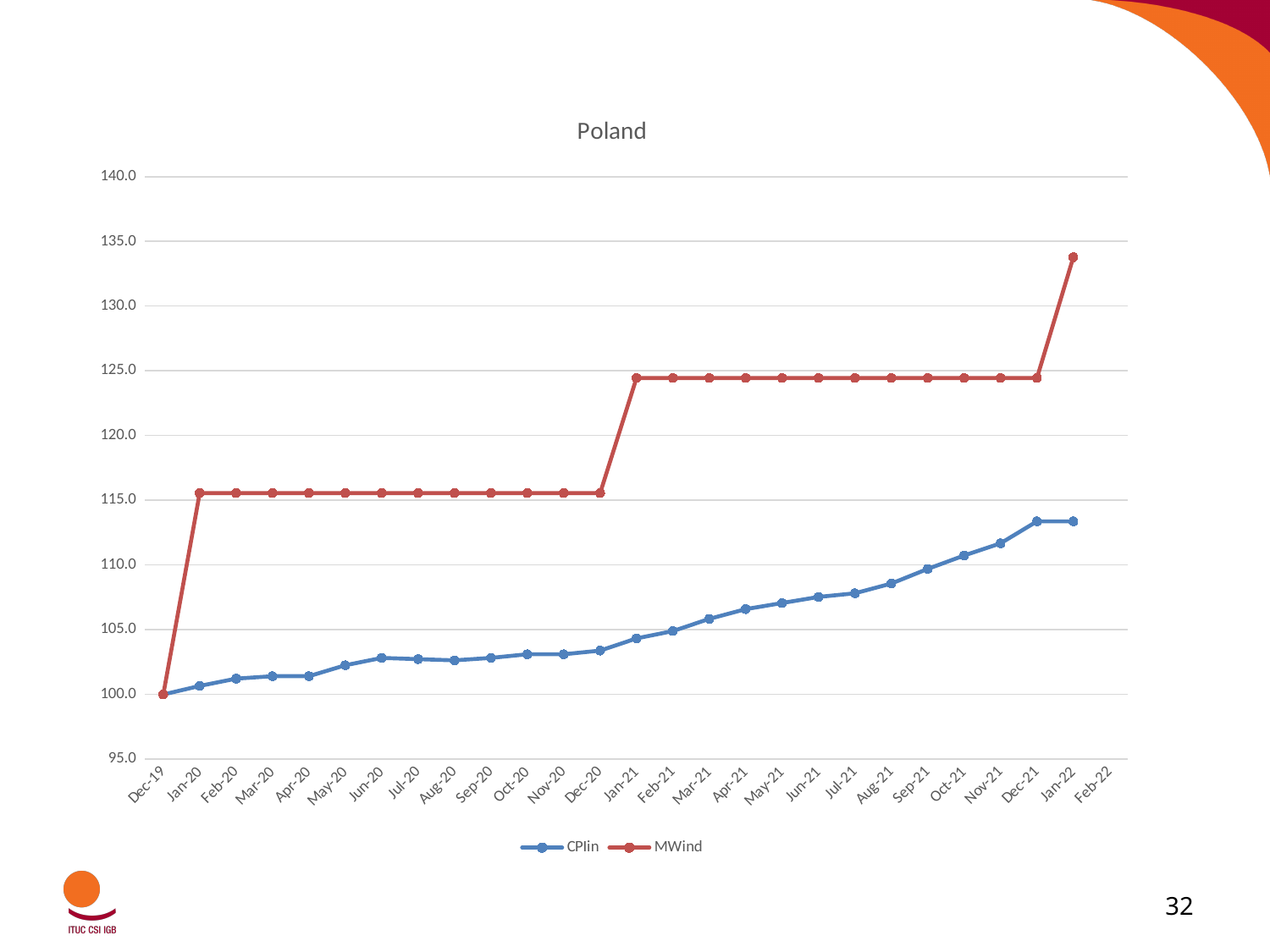
What is the title of the chart? Poland Is the value for CPIin at Dec-20 greater or less than 105.0? less Is the value for CPIin at Jan-22 greater or less than 110.0? greater Is the value for MWind at Jun-21 greater or less than 120.0? greater What is the value of CPIin at Dec-19? 100.0 Does the CPIin series generally rise or fall from Dec-19 to Jan-22? Rise Which colour is used for the MWind series? Red How many series does the legend list? 2 What is the value of MWind at Dec-19? 100.0 What kind of chart is shown on the slide? Line chart Which series has the higher value at Dec-21, CPIin or MWind? MWind